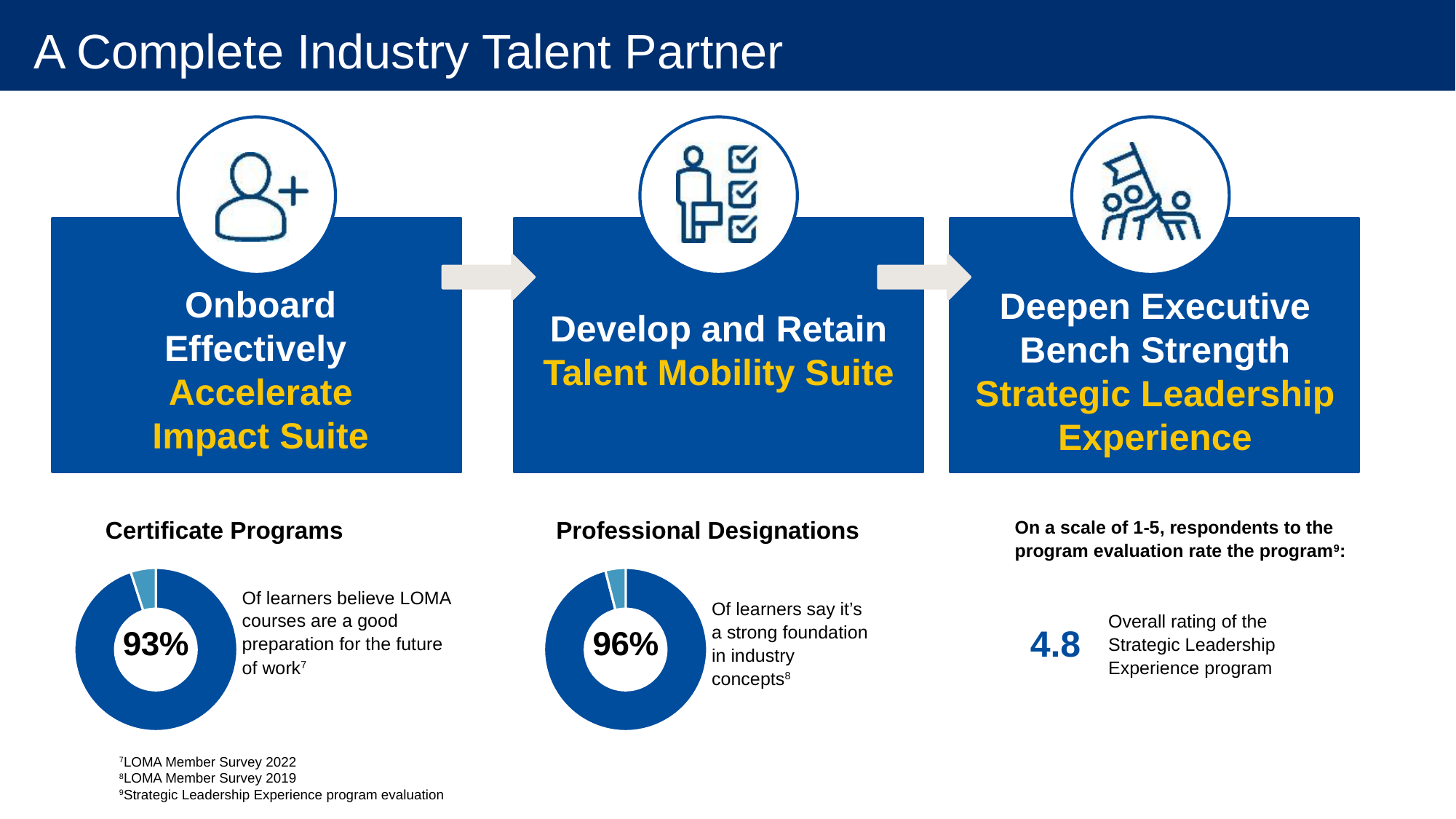
What is the difference between the percentage in the Professional Designations chart and the percentage in the Certificate Programs chart? 3 percentage points What type of chart is used under the Certificate Programs heading? Donut chart What percentage is shown in the centre of the Professional Designations donut chart? 96% Which chart shows the higher percentage, Certificate Programs or Professional Designations? Professional Designations What percentage is shown in the centre of the Certificate Programs donut chart? 93% What is the heading above the donut chart showing 96%? Professional Designations In the Professional Designations donut chart, what share of the ring does the large dark blue segment represent? 96% Is the value shown in the Certificate Programs donut chart greater or less than 90%? greater What type of chart is used under the Professional Designations heading? Donut chart What colour is the large segment in both donut charts? Dark blue How many donut charts are shown on the slide? 2